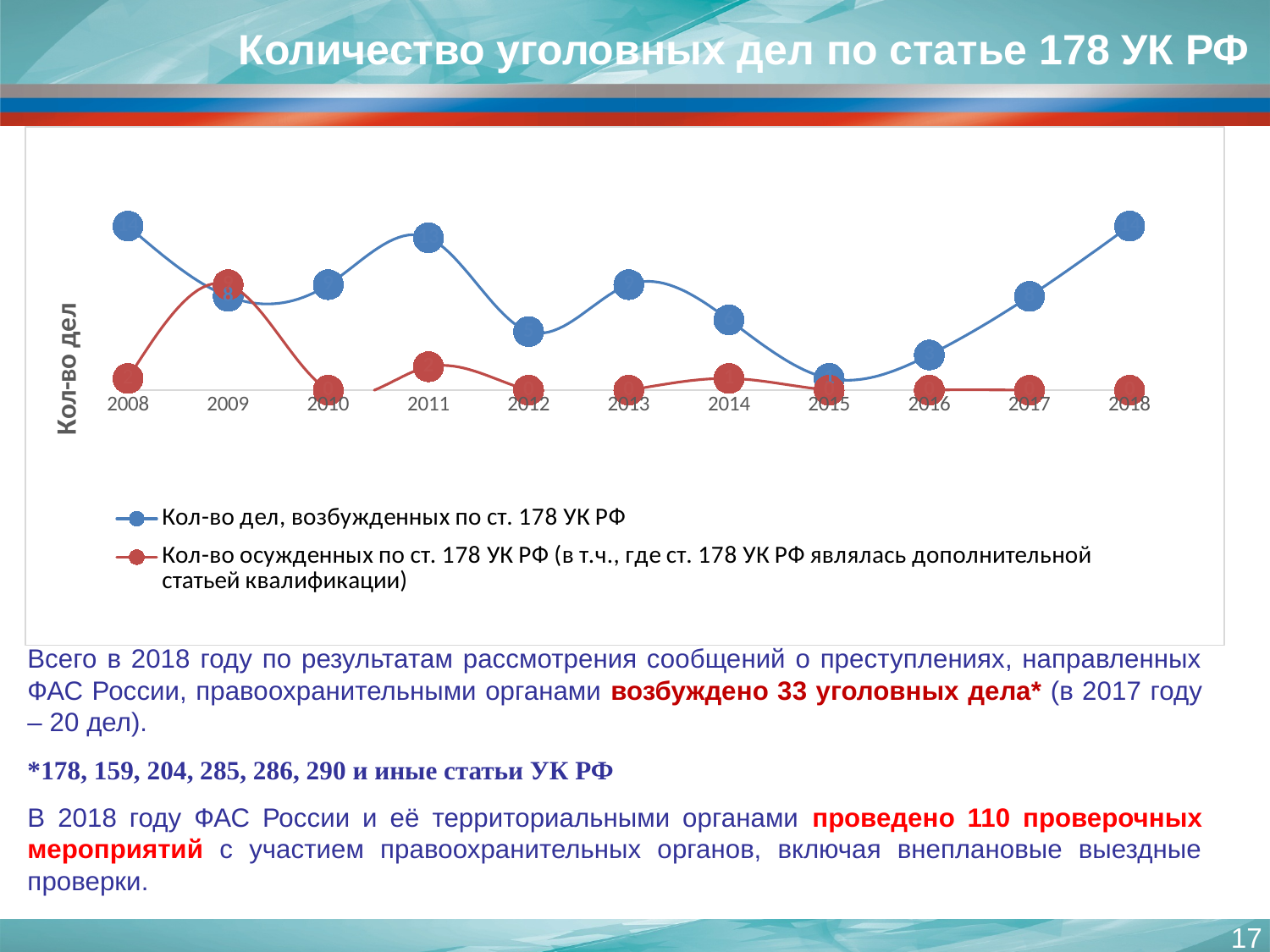
For the series 'Кол-во дел, возбужденных по ст. 178 УК РФ', which year has the larger value, 2011 or 2012? 2011 For the series 'Кол-во дел, возбужденных по ст. 178 УК РФ', which year has the larger value, 2013 or 2014? 2013 What is the label of the y axis? Кол-во дел Does the series 'Кол-во дел, возбужденных по ст. 178 УК РФ' rise or fall from 2015 to 2018? rise Does the series 'Кол-во дел, возбужденных по ст. 178 УК РФ' rise or fall from 2013 to 2015? fall In which year is the series 'Кол-во осужденных по ст. 178 УК РФ' at its highest? 2009 What kind of chart is shown on the slide? line chart How many years are plotted along the x axis? 11 In which year is the series 'Кол-во дел, возбужденных по ст. 178 УК РФ' at its lowest? 2015 For the series 'Кол-во осужденных по ст. 178 УК РФ', which year has the larger value, 2009 or 2011? 2009 How many series does the legend list? 2 What is the title of the chart? Количество уголовных дел по статье 178 УК РФ